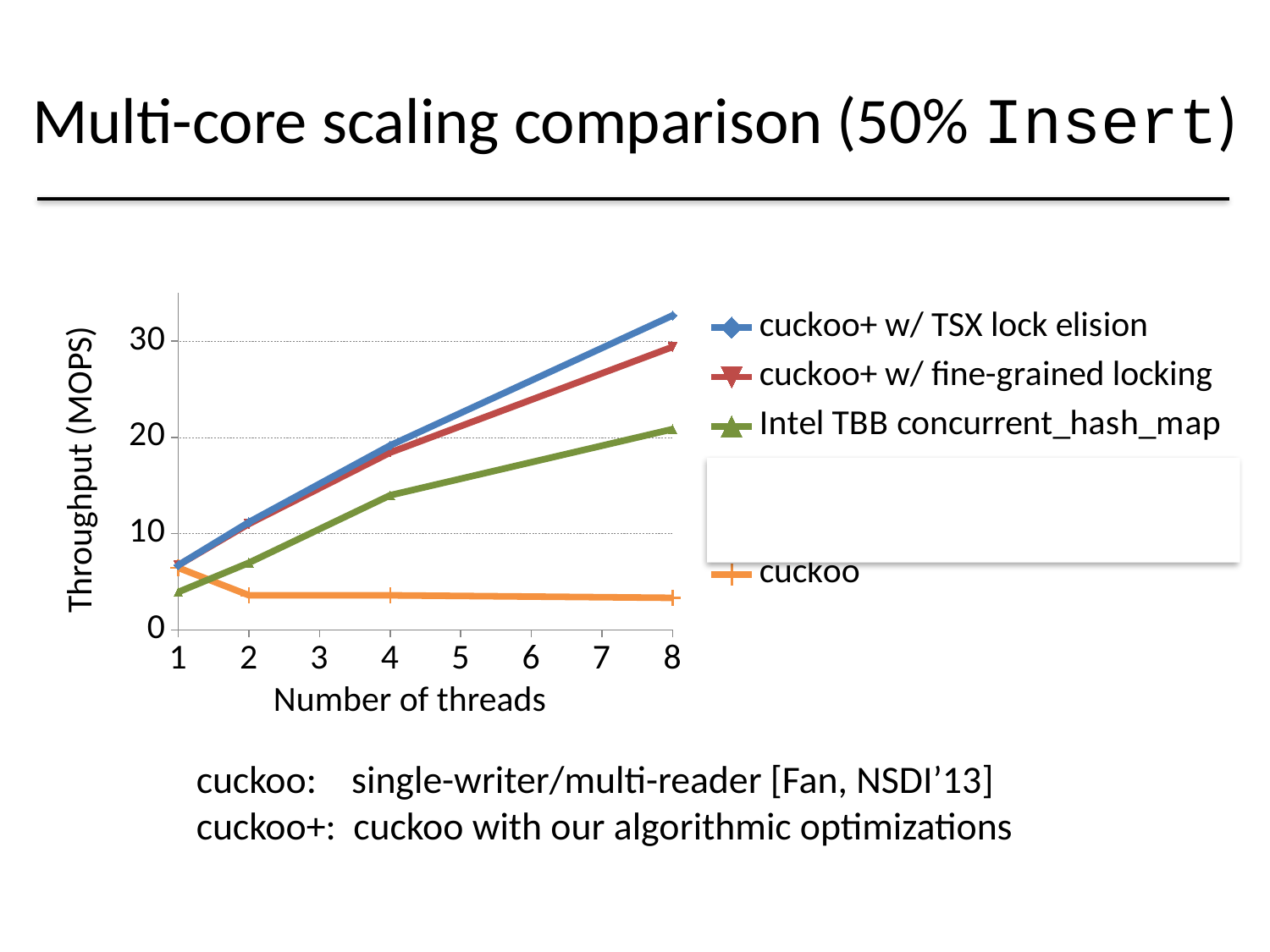
At 8 threads, which has higher throughput: Intel TBB concurrent_hash_map or cuckoo? Intel TBB concurrent_hash_map Does the throughput of cuckoo+ w/ fine-grained locking rise or fall as the number of threads increases? rise Which series has the highest throughput at 8 threads? cuckoo+ w/ TSX lock elision What kind of chart is shown on the slide? line chart Which series has the lowest throughput at 8 threads? cuckoo Is the throughput of cuckoo+ w/ TSX lock elision at 8 threads greater or less than 30? greater Is the throughput of cuckoo at 8 threads greater or less than 10? less Is the throughput of Intel TBB concurrent_hash_map at 4 threads greater or less than 10? greater Does the throughput of the cuckoo series rise or fall as the number of threads increases? fall How many lines are plotted on the chart? 4 What is the label of the y axis of the chart? Throughput (MOPS) What is the title of the chart on the slide? Multi-core scaling comparison (50% Insert)